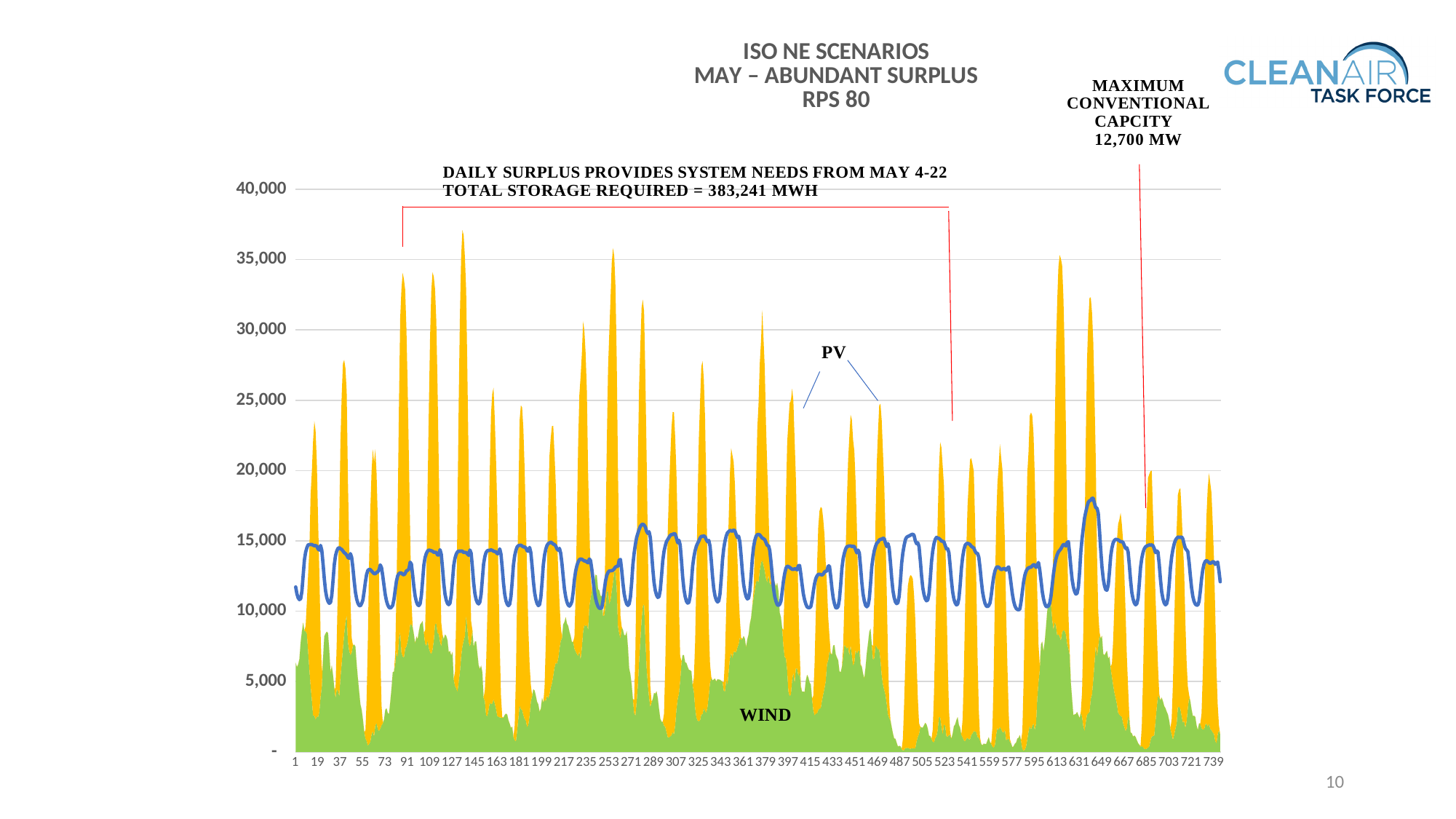
Is the highest value of the blue line greater or less than 20,000? less What kind of chart is shown on the slide? area chart What is the highest value shown on the vertical axis? 40,000 Which reaches a higher peak, PV or WIND? PV What is the title of the chart? ISO NE SCENARIOS MAY – ABUNDANT SURPLUS RPS 80 What is the total storage required stated on the chart? 383,241 MWH Which series is shown as the green area? WIND What is the last label on the horizontal axis? 739 According to the annotation, over which dates does the daily surplus provide system needs? May 4-22 Is the highest WIND value greater or less than 10,000? greater What maximum conventional capacity is annotated on the chart? 12,700 MW